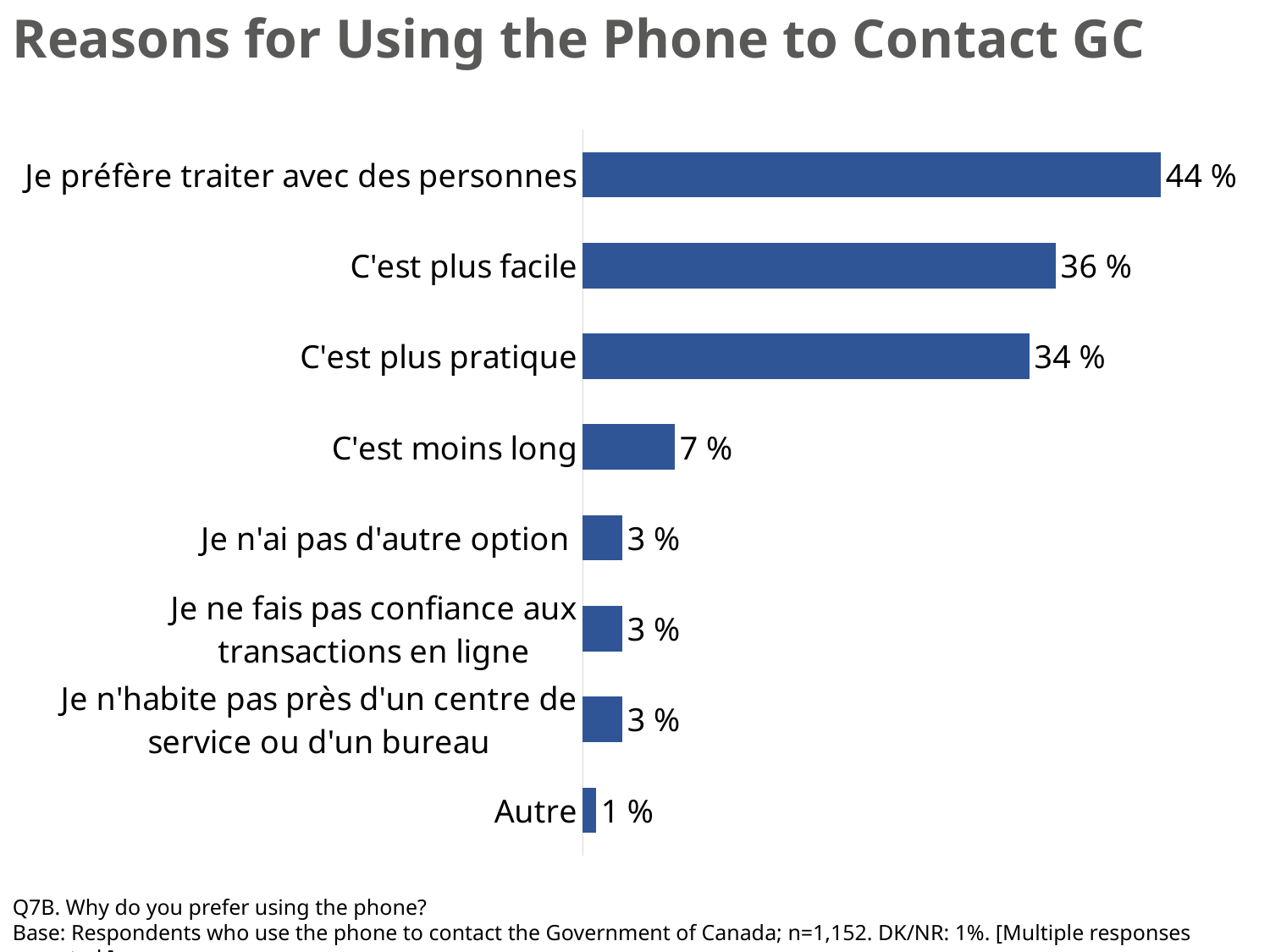
What is the title of the chart? Reasons for Using the Phone to Contact GC What is the value for "C'est moins long"? 7 % How many categories are shown in the chart? 8 What kind of chart is shown on the slide? Bar chart Which category has the highest value? Je préfère traiter avec des personnes What is the value for "C'est plus pratique"? 34 % What is the value for "Je préfère traiter avec des personnes"? 44 % Which is larger, "C'est plus facile" or "C'est plus pratique"? C'est plus facile Which category has the lowest value? Autre What is the value for "C'est plus facile"? 36 % What is the difference between "Je préfère traiter avec des personnes" and "C'est plus facile"? 8 % What is the value for "Autre"? 1 %